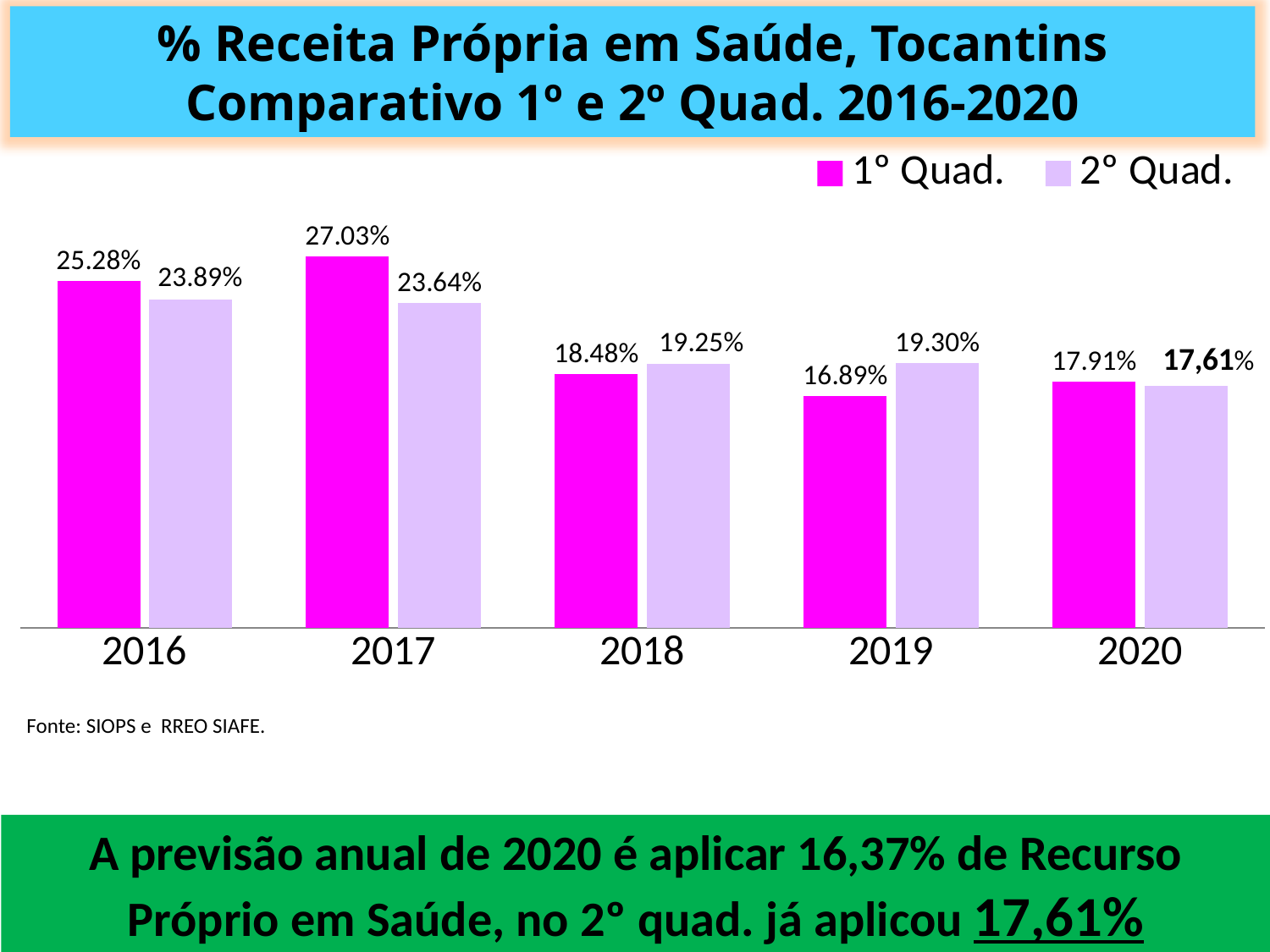
Which year has the highest 1° Quad. value? 2017 In 2019, which is larger: the 1° Quad. value or the 2° Quad. value? 2° Quad. Which year has the lowest 2° Quad. value? 2020 What is the value for 2° Quad. in 2020? 17,61% How many years are shown on the x axis? 5 What is the value for 1° Quad. in 2016? 25.28% What is the difference between the 1° Quad. and 2° Quad. values in 2017? 3.39% How many series does the legend list? 2 Which year has the lowest 1° Quad. value? 2019 What is the value for 1° Quad. in 2017? 27.03% What kind of chart is shown on the slide? Bar chart What is the value for 2° Quad. in 2019? 19.30%